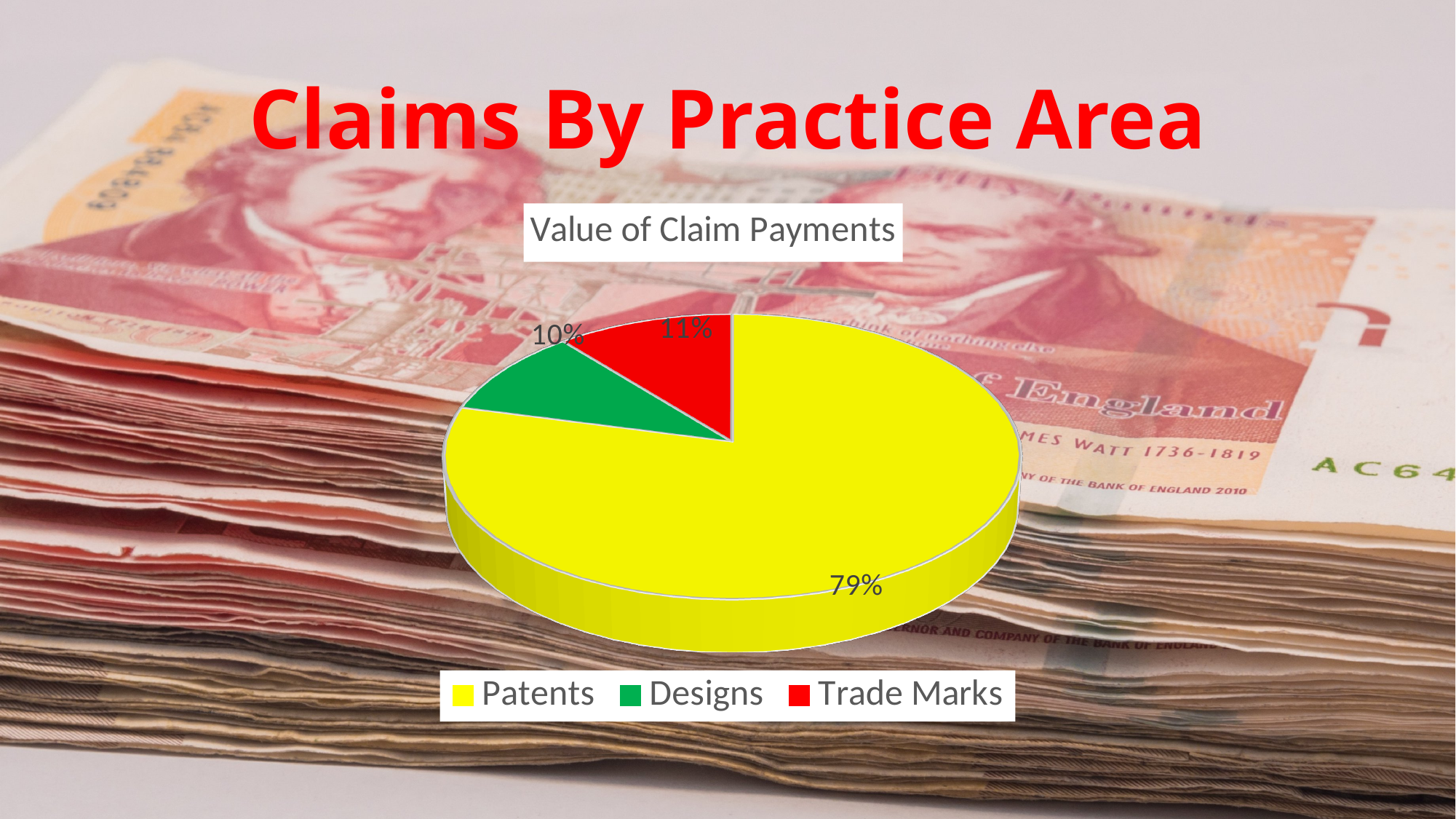
What kind of chart is shown on the slide? Pie chart What colour represents Designs in the pie chart? Green What is the difference in percentage points between the Patents share and the Trade Marks share? 68 What is the title of the chart? Value of Claim Payments What share of the value of claim payments is for Designs? 10% What share of the value of claim payments is for Trade Marks? 11% Which practice area has the smallest share of claim payments? Designs What share of the value of claim payments is for Patents? 79% How many slices does the pie chart have? 3 Which is larger, the share for Trade Marks or the share for Designs? Trade Marks Which practice area has the largest share of claim payments? Patents How many entries does the legend list? 3